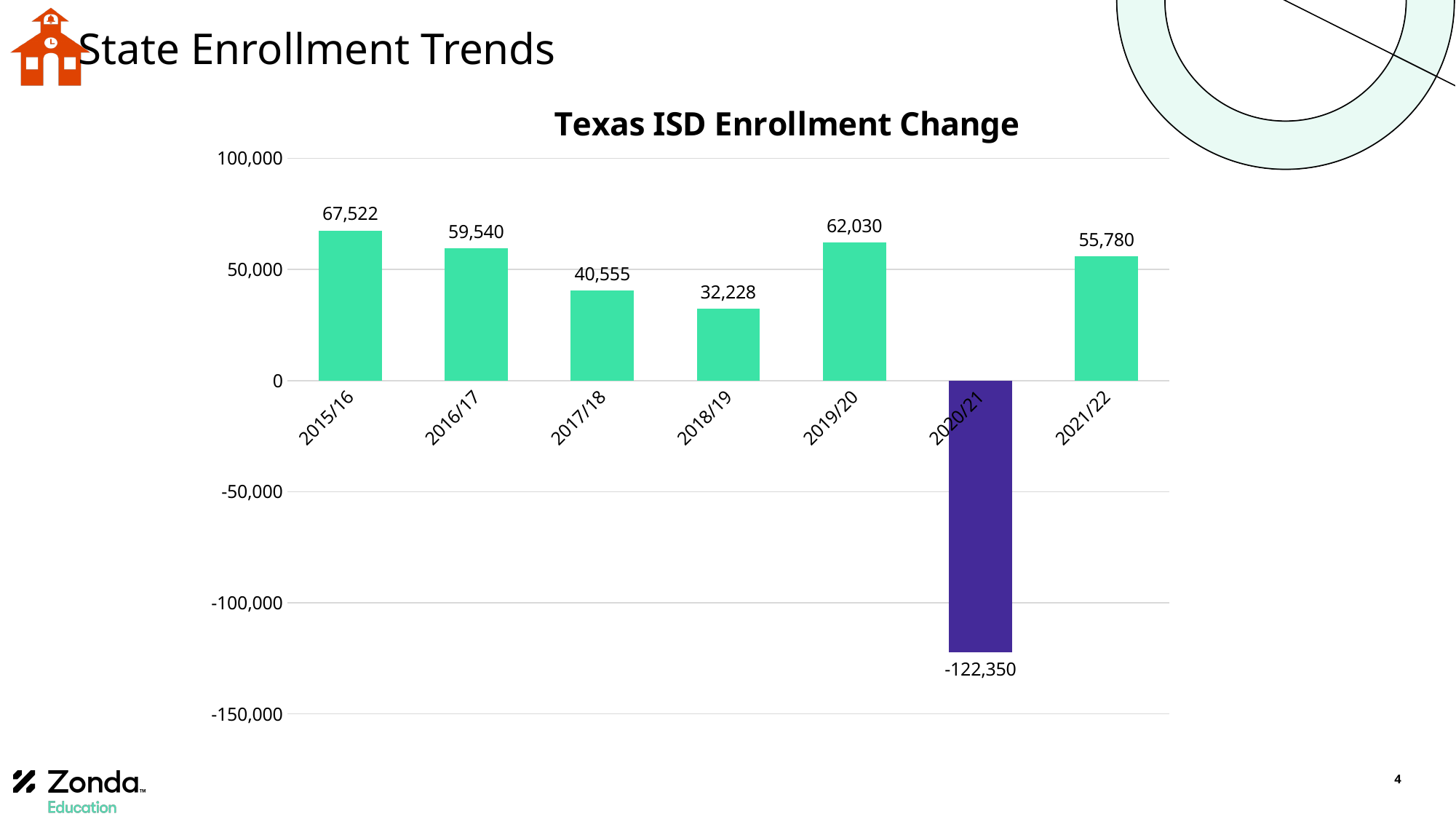
Which school year has the lowest enrollment change? 2020/21 Does the enrollment change rise or fall from 2015/16 to 2018/19? fall What is the title of the chart? Texas ISD Enrollment Change What kind of chart is shown on the slide? bar chart What is the Texas ISD enrollment change for 2018/19? 32,228 How many school years are shown on the chart? 7 What is the difference between the enrollment change in 2019/20 and 2018/19? 29,802 What is the Texas ISD enrollment change for 2020/21? -122,350 Is the enrollment change for 2017/18 greater or less than 50,000? less What is the Texas ISD enrollment change for 2015/16? 67,522 Which is larger, the enrollment change for 2016/17 or for 2021/22? 2016/17 Which school year has the highest enrollment change? 2015/16